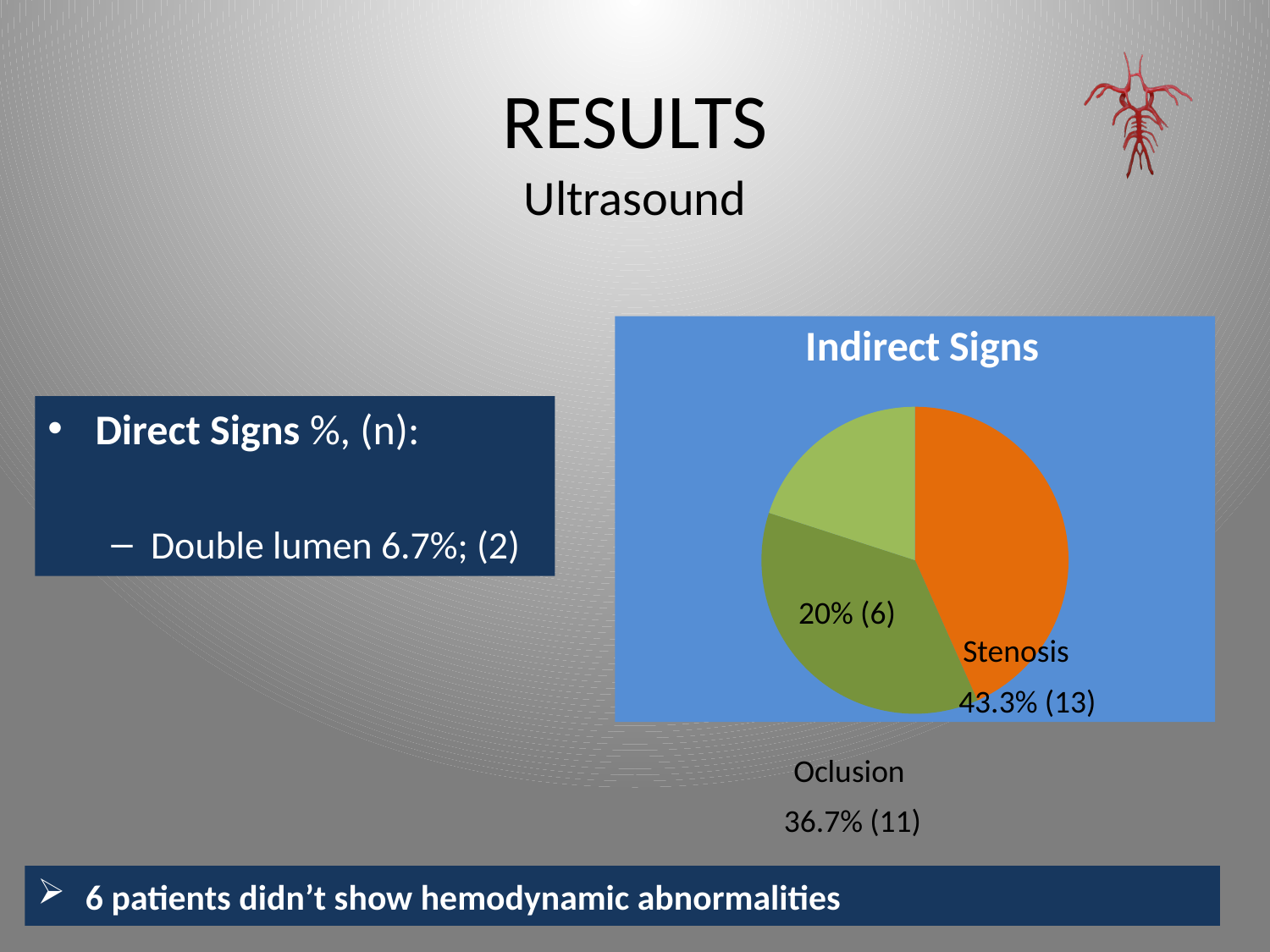
What colour is the Stenosis slice in the Indirect Signs pie chart? orange Which labelled category has the largest slice in the Indirect Signs pie chart? Stenosis What value is printed for the smallest slice of the Indirect Signs pie chart? 20% (6) How many more patients had Stenosis than Oclusion according to the Indirect Signs pie chart? 2 By how many percentage points does Stenosis exceed Oclusion in the Indirect Signs pie chart? 6.6 What is the title of the pie chart? Indirect Signs How many slices does the Indirect Signs pie chart have? 3 What share of the Indirect Signs pie does Stenosis represent? 43.3% Which is larger in the Indirect Signs pie chart, Stenosis or Oclusion? Stenosis What value is shown for Stenosis in the Indirect Signs pie chart? 43.3% (13) What value is shown for Oclusion in the Indirect Signs pie chart? 36.7% (11) What kind of chart is shown under the title "Indirect Signs"? pie chart